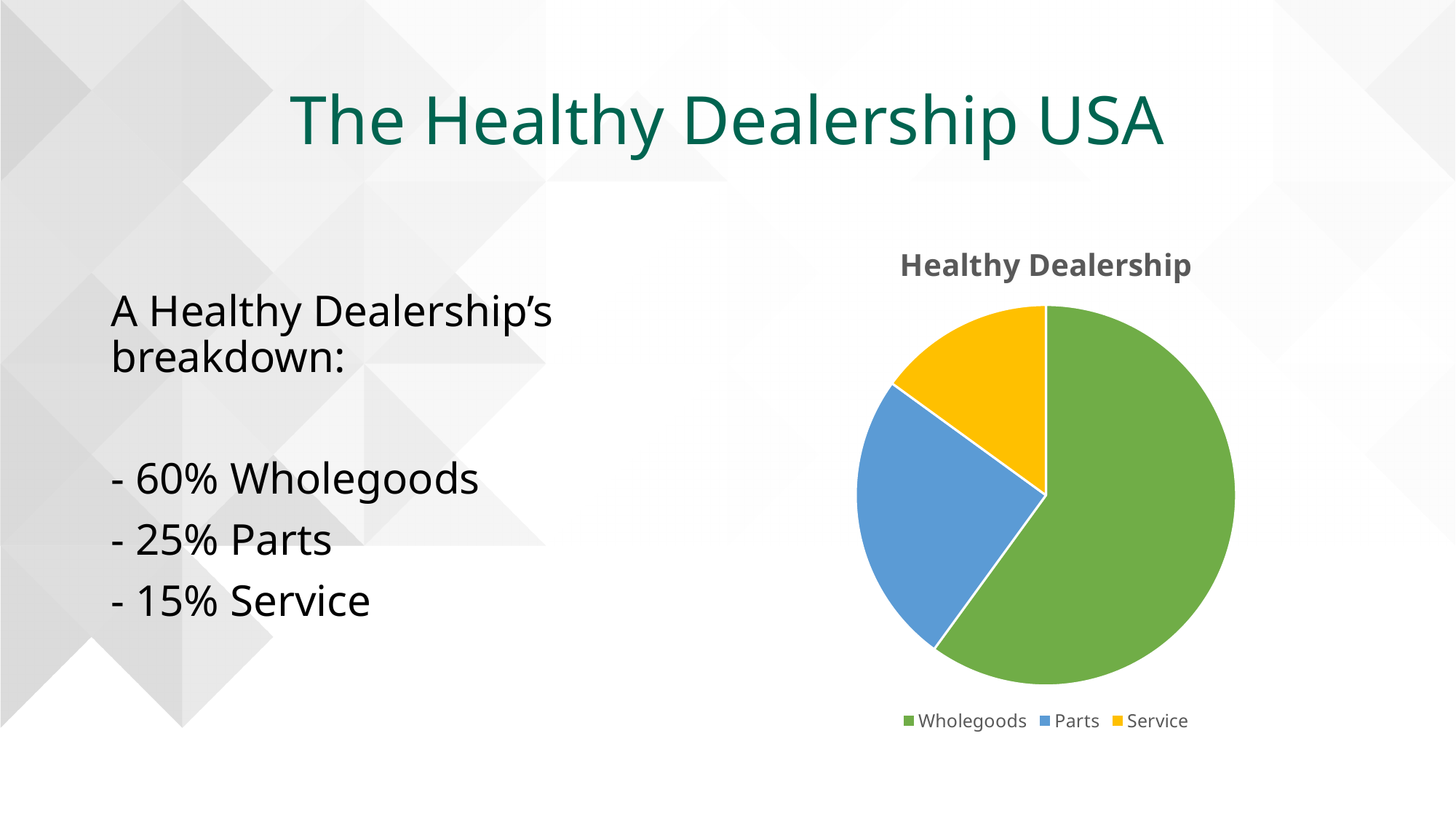
Which category has the largest slice of the pie? Wholegoods What is the difference in percentage points between the Wholegoods share and the Parts share? 35 What colour is the Wholegoods slice in the pie chart? Green Which slice is larger, Parts or Service? Parts According to the slide, what share of the pie does Service represent? 15% According to the slide, what share of the pie does Parts represent? 25% According to the slide, what share of the pie does Wholegoods represent? 60% How many slices does the pie chart have? 3 What is the title of the chart? Healthy Dealership Which category has the smallest slice of the pie? Service What kind of chart is shown on the slide? Pie chart How many entries does the chart legend list? 3